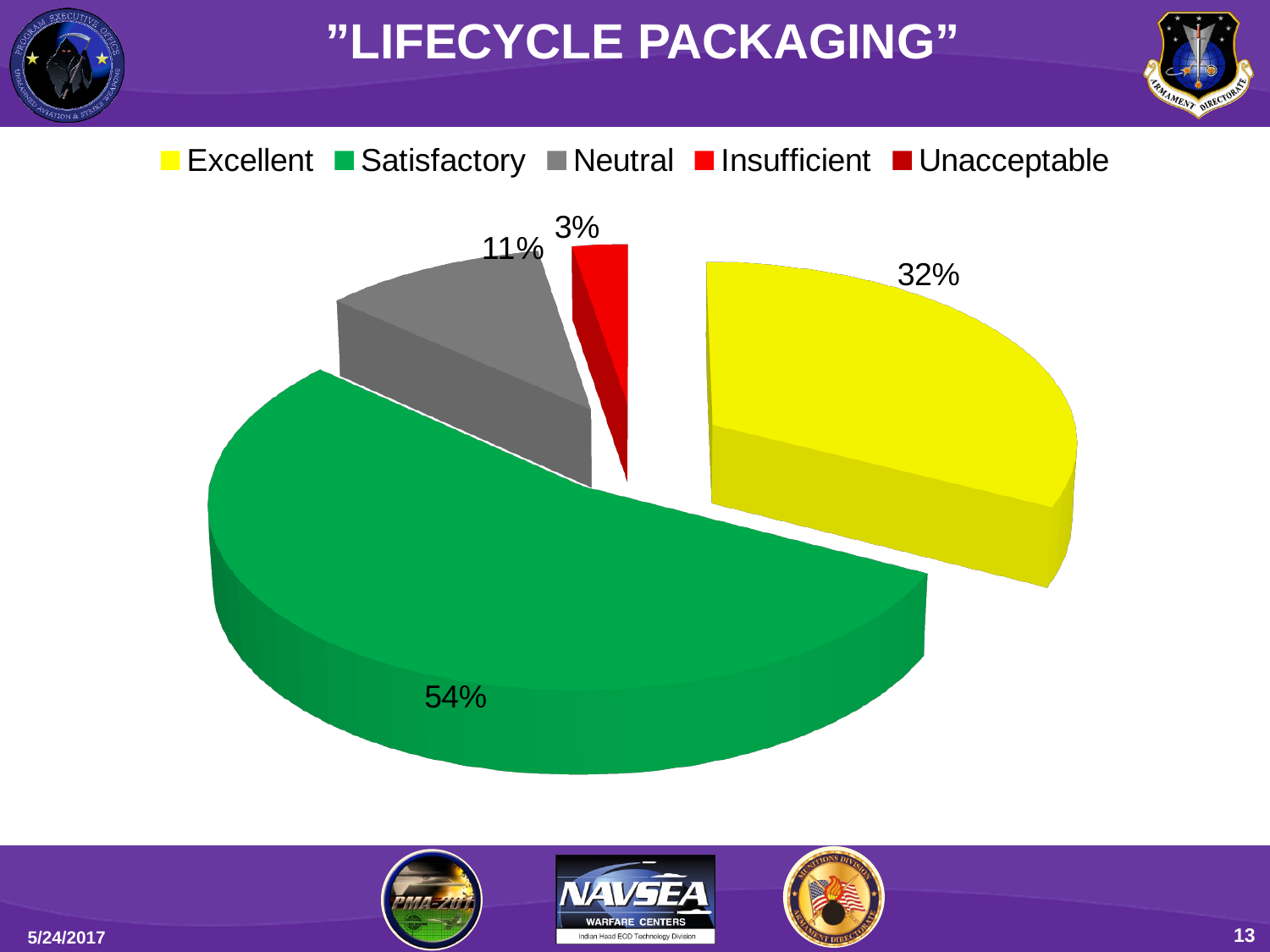
Which is larger, the Neutral slice or the Insufficient slice? Neutral Which category has the largest share of the pie? Satisfactory What percentage of the pie is labelled Satisfactory? 54% What percentage of the pie is labelled Insufficient? 3% Which labelled slice has the smallest share of the pie? Insufficient What percentage of the pie is labelled Excellent? 32% How many slices with percentage labels are shown in the pie? 4 What percentage of the pie is labelled Neutral? 11% What colour is the Excellent slice? Yellow What is the difference in percentage points between the Satisfactory and Excellent slices? 22 How many categories does the legend list? 5 What kind of chart is shown on the slide? Pie chart